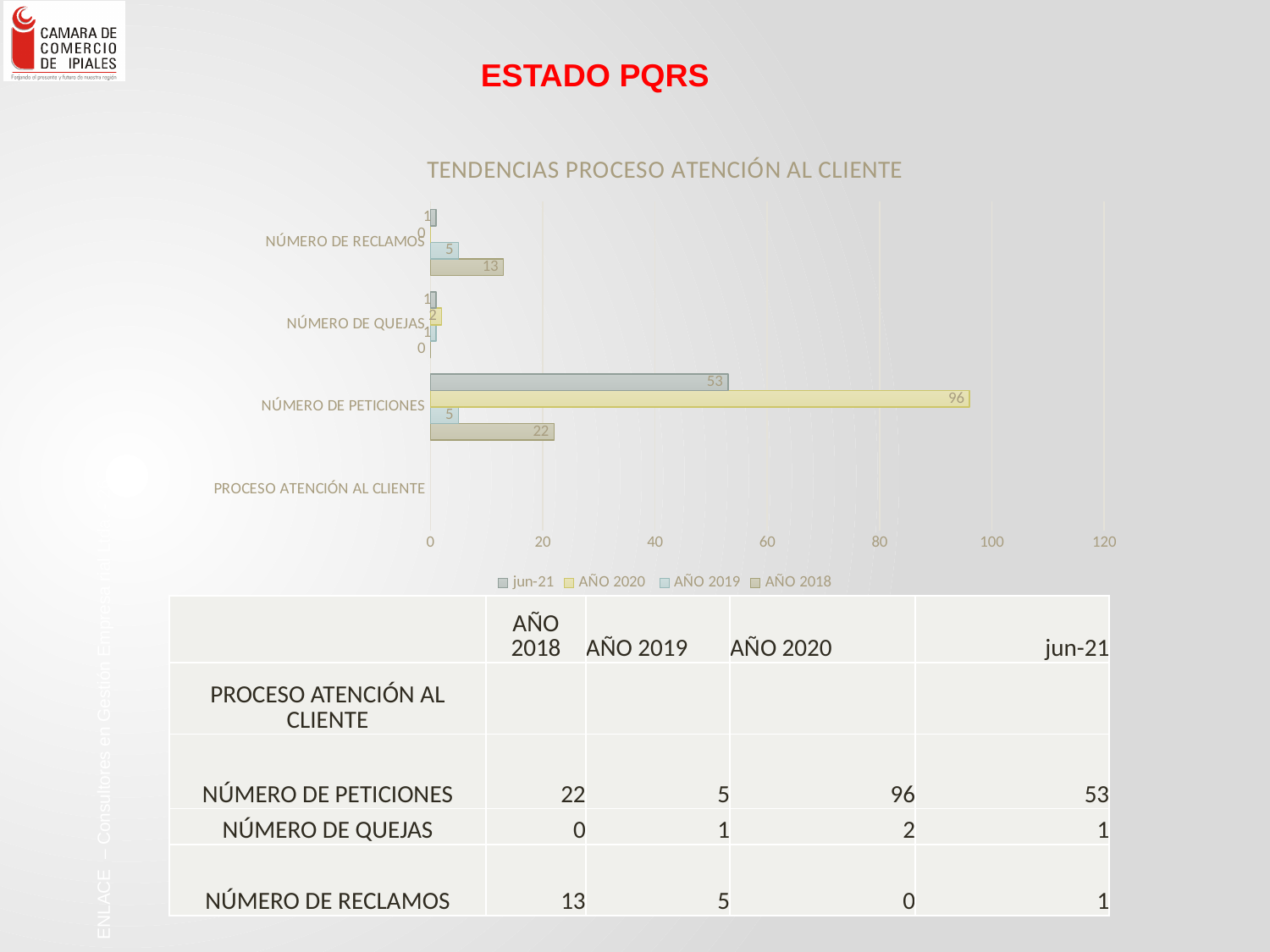
What is the value for NÚMERO DE PETICIONES in the jun-21 series? 53 How many series does the chart legend list? 4 Which series has the lowest value for NÚMERO DE RECLAMOS? AÑO 2020 What kind of chart is shown on the slide? Bar chart What is the title of the chart? TENDENCIAS PROCESO ATENCIÓN AL CLIENTE Is the AÑO 2020 value for NÚMERO DE PETICIONES greater or less than 80? greater What is the value for NÚMERO DE PETICIONES in the AÑO 2020 series? 96 What is the value for NÚMERO DE RECLAMOS in the AÑO 2018 series? 13 Which is larger for NÚMERO DE PETICIONES: the AÑO 2018 value or the AÑO 2019 value? AÑO 2018 What is the difference between the AÑO 2020 and jun-21 values for NÚMERO DE PETICIONES? 43 Which series has the highest value for NÚMERO DE PETICIONES? AÑO 2020 What is the value for NÚMERO DE QUEJAS in the AÑO 2020 series? 2